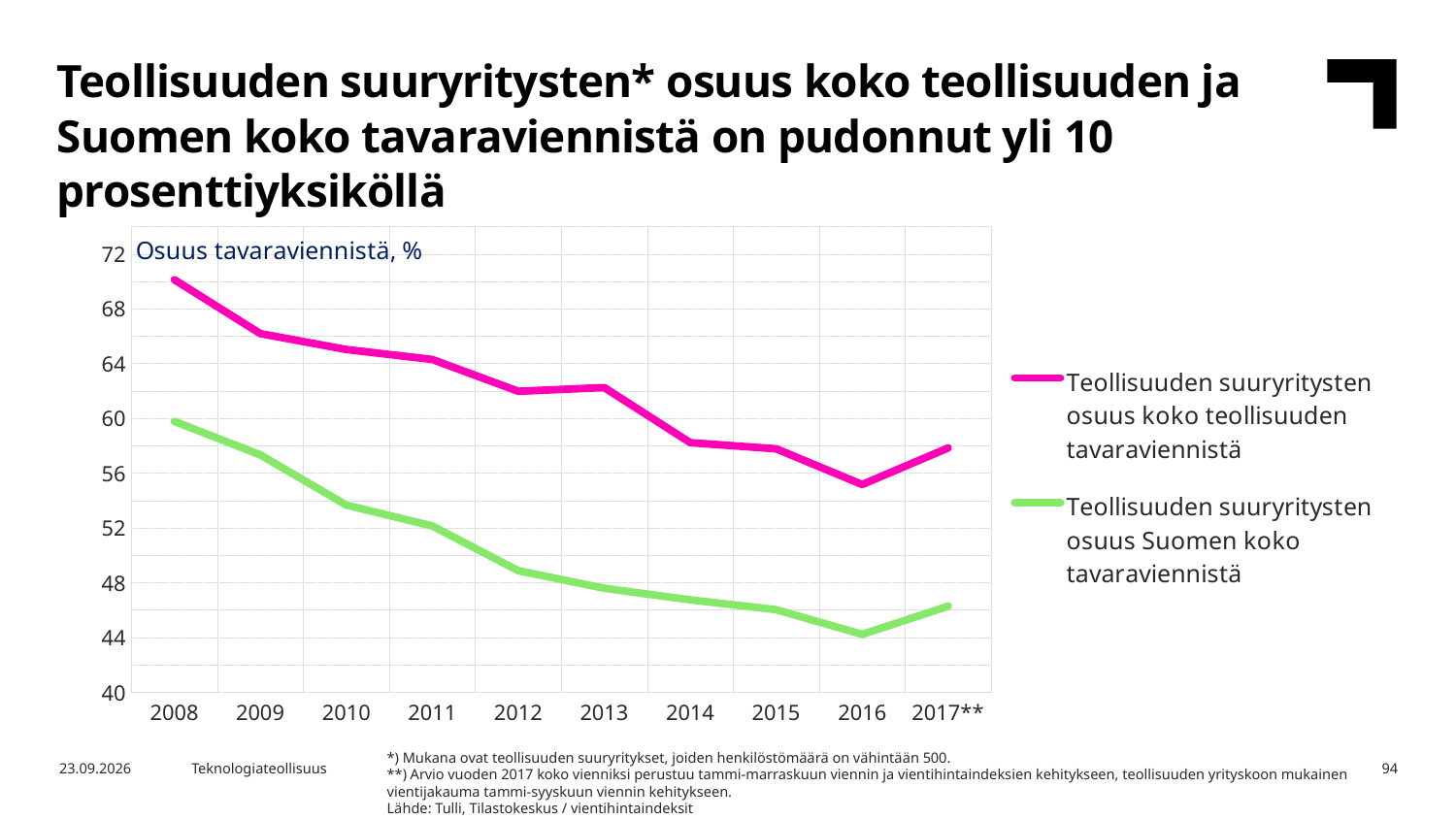
Which series has the higher value in 2013: 'Teollisuuden suuryritysten osuus koko teollisuuden tavaraviennistä' or 'Teollisuuden suuryritysten osuus Suomen koko tavaraviennistä'? Teollisuuden suuryritysten osuus koko teollisuuden tavaraviennistä How many series does the legend list? 2 Is the 2008 value for 'Teollisuuden suuryritysten osuus koko teollisuuden tavaraviennistä' greater or less than 68? greater In which year is the value for 'Teollisuuden suuryritysten osuus Suomen koko tavaraviennistä' lowest? 2016 Does the series 'Teollisuuden suuryritysten osuus Suomen koko tavaraviennistä' generally rise or fall from 2008 to 2016? fall In which year is the value for 'Teollisuuden suuryritysten osuus koko teollisuuden tavaraviennistä' highest? 2008 What kind of chart is shown on the slide? line chart What is the label shown at the top of the chart area? Osuus tavaraviennistä, % Is the 2016 value for 'Teollisuuden suuryritysten osuus koko teollisuuden tavaraviennistä' greater or less than 56? less How many years are plotted along the x axis? 10 What colour is the line for 'Teollisuuden suuryritysten osuus Suomen koko tavaraviennistä'? green Is the 2015 value for 'Teollisuuden suuryritysten osuus Suomen koko tavaraviennistä' greater or less than 48? less